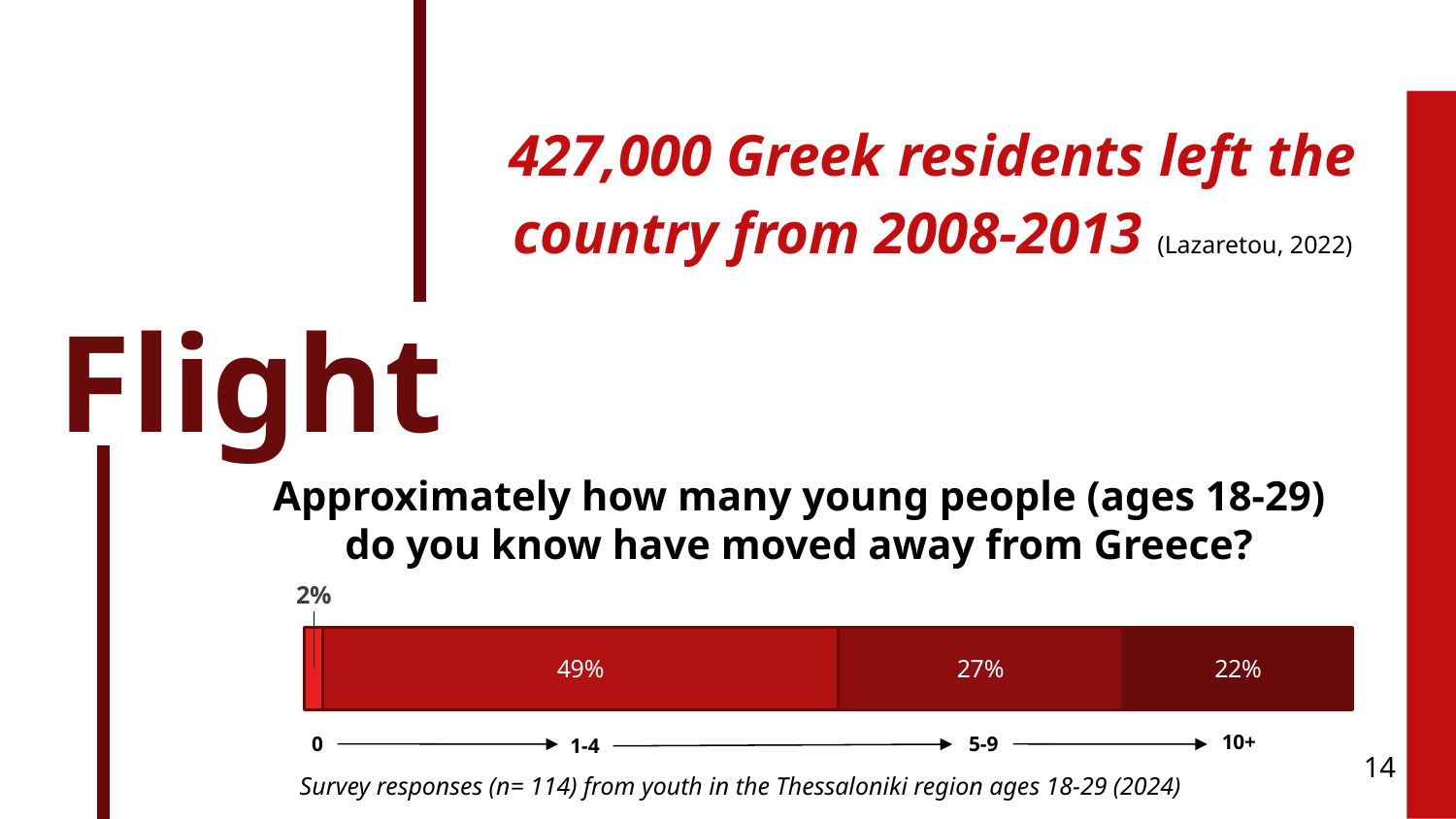
What is the combined percentage of respondents who know 5 or more young people who have moved away (5-9 and 10+)? 49% What is the difference in percentage points between the 1-4 category and the 5-9 category? 22 What percentage of respondents said they know 10+ young people who have moved away from Greece? 22% Which response category has the largest share of respondents? 1-4 What is the difference in percentage points between the 5-9 category and the 10+ category? 5 What percentage of respondents said they know 5-9 young people who have moved away from Greece? 27% What percentage of respondents said they know 0 young people who have moved away from Greece? 2% Which response category has the smallest share of respondents? 0 How many response categories are shown in the bar? 4 What percentage of respondents said they know 1-4 young people who have moved away from Greece? 49% Which category has a larger share: 5-9 or 10+? 5-9 What kind of chart is used to show the survey responses? Stacked bar chart